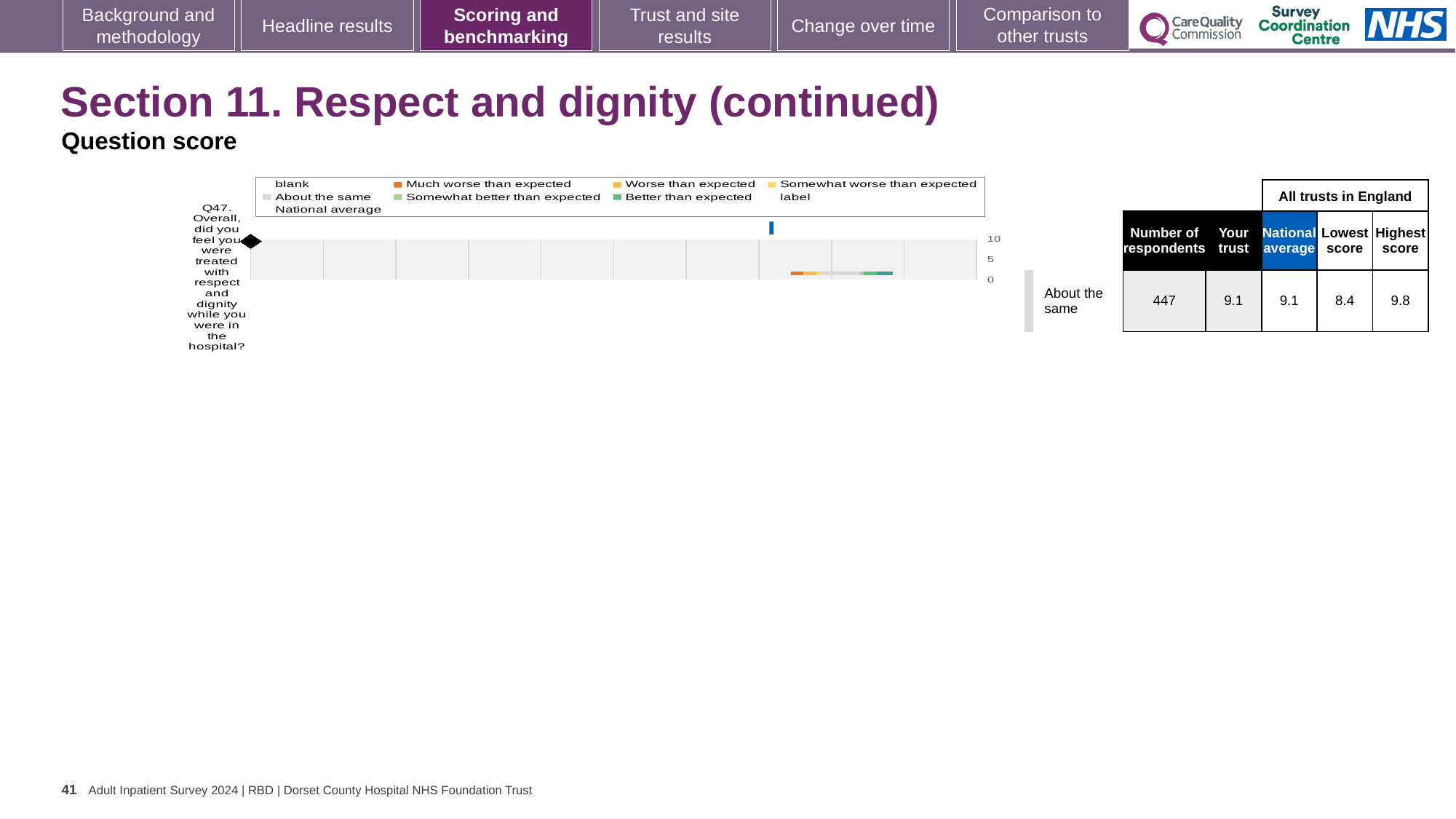
What is the national average score for Q47? 9.1 What is the 'Your trust' score for Q47? 9.1 What kind of chart is shown on the slide for Q47? bar chart What is the highest score among all trusts in England for Q47? 9.8 What benchmark category is the trust's Q47 score placed in? About the same How many survey questions are plotted in the chart? 1 How many respondents answered Q47? 447 What is the difference between the highest score and the trust's score for Q47? 0.7 Which question number is plotted in the chart? Q47 What is the difference between the highest score and the lowest score for Q47? 1.4 What is the lowest score among all trusts in England for Q47? 8.4 Which legend entry is shown in orange? Much worse than expected